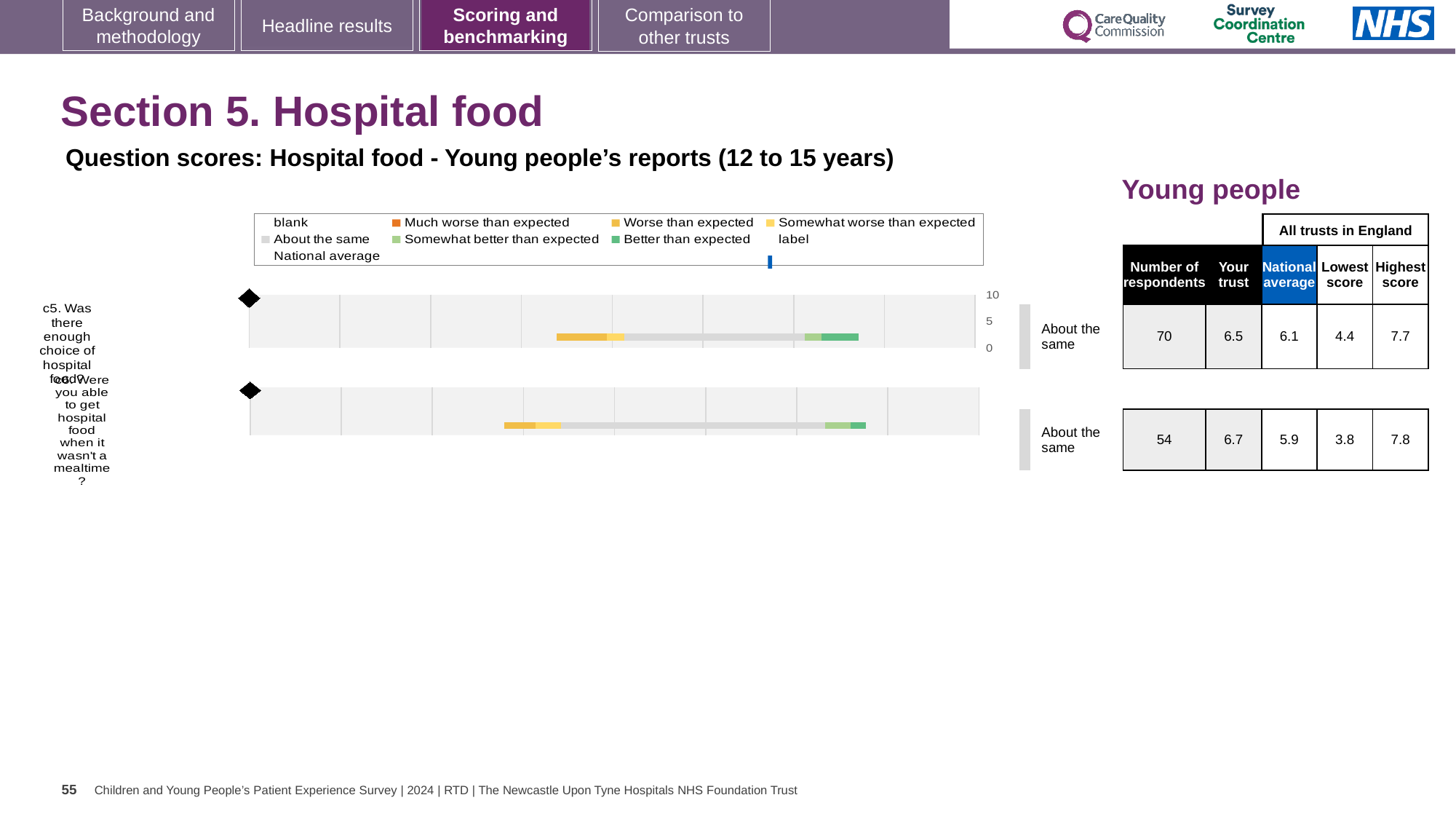
What is the lowest score across all trusts in England for question c5? 4.4 What is the 'Your trust' score for question c5 (Was there enough choice of hospital food?)? 6.5 What is the difference between the highest score and the lowest score for question c6? 4.0 For question c6, is the 'Your trust' score or the national average higher? Your trust How many survey questions are plotted in the hospital food chart? 2 What benchmark category is shown next to question c5 in the hospital food chart? About the same What kind of chart is used to show the question scores for hospital food? bar chart Which question has the higher 'Your trust' score, c5 or c6? c6 By how much does the 'Your trust' score for question c5 exceed the national average? 0.4 What is the highest value shown on the vertical axis of the hospital food chart? 10 How many respondents answered question c5 about choice of hospital food? 70 What is the national average score for question c6 (Were you able to get hospital food when it wasn't a mealtime?)? 5.9